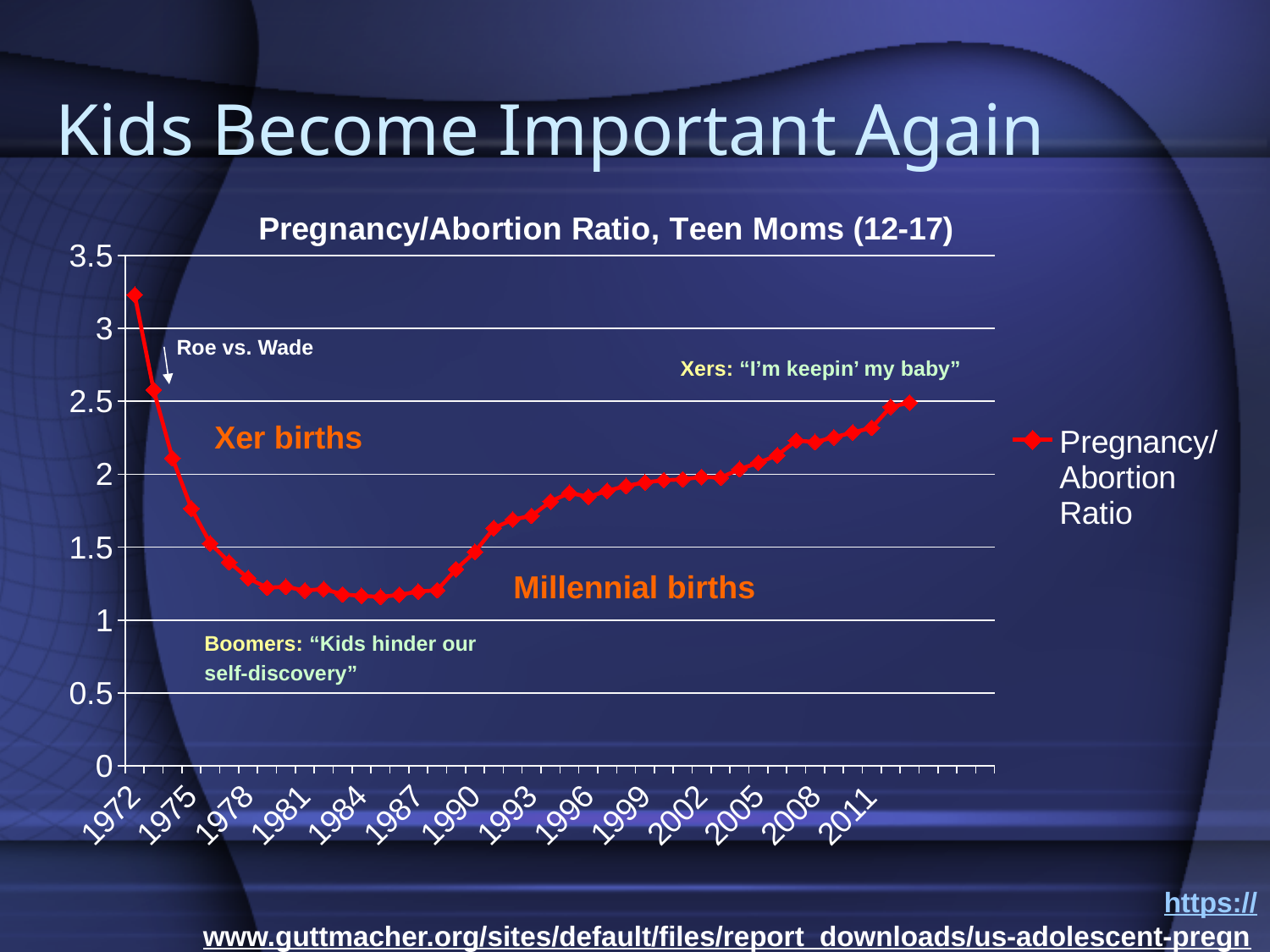
What is the title of the chart? Pregnancy/Abortion Ratio, Teen Moms (12-17) Does the Pregnancy/Abortion Ratio rise or fall between 1972 and 1984? fall How many series does the legend list? 1 Which year has the highest Pregnancy/Abortion Ratio? 1972 Does the Pregnancy/Abortion Ratio rise or fall between 1990 and 2011? rise Is the value for 1978 greater or less than 1.5? less Is the value for 1972 greater or less than 3? greater Is the value for 1993 greater or less than 1.5? greater What is the name of the series shown in the legend? Pregnancy/Abortion Ratio What kind of chart is shown on the slide? line chart